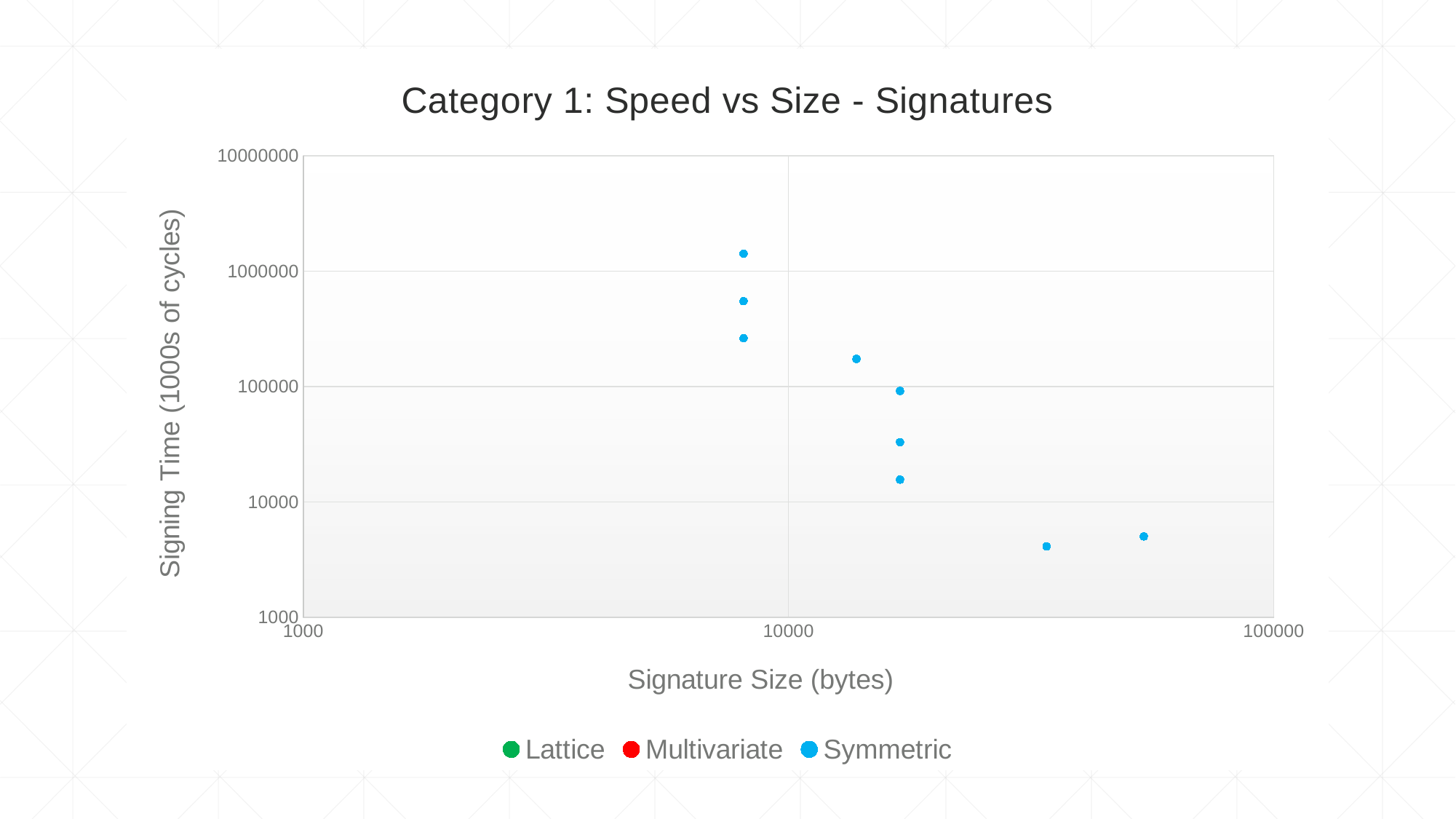
What kind of chart is shown on the slide? Scatter chart How many data points are plotted on the chart? 9 Is the signing time of the highest plotted point greater or less than 1000000? greater Is the signing time of the lowest plotted point greater or less than 1000? greater As signature size increases along the x axis, does signing time generally rise or fall? Fall What is the title of the chart? Category 1: Speed vs Size - Signatures How many series does the legend list? 3 Is the signing time of the point with the largest signature size greater or less than 10000? less Which series do all the plotted points belong to? Symmetric What is the label of the x axis? Signature Size (bytes) Which has the larger signing time: the point with the smallest signature size or the point with the largest signature size? The point with the smallest signature size